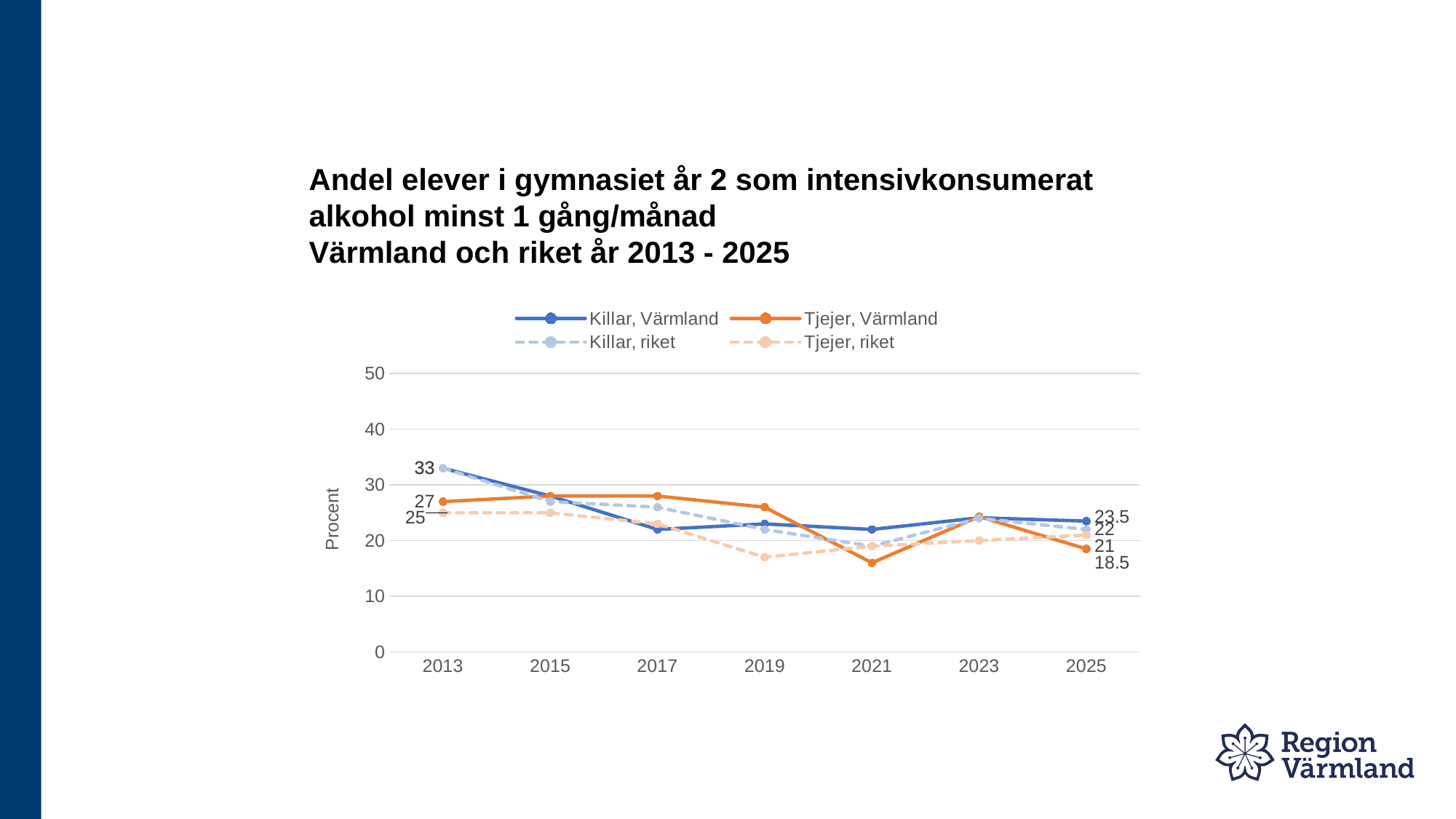
How many series does the legend list? 4 In which year is the value for Tjejer, Värmland lowest? 2021 What is the value for Tjejer, Värmland in 2025? 18.5 What is the value for Killar, Värmland in 2013? 33 Which is larger in 2025, Killar, Värmland or Tjejer, Värmland? Killar, Värmland How many years are plotted along the x axis? 7 What is the label on the y axis? Procent What kind of chart is shown on the slide? line chart Is the value for Tjejer, Värmland in 2021 greater or less than 20? less What is the value for Tjejer, Värmland in 2013? 27 By how much did the value for Killar, Värmland fall from 2013 to 2025? 9.5 What is the value for Killar, Värmland in 2025? 23.5